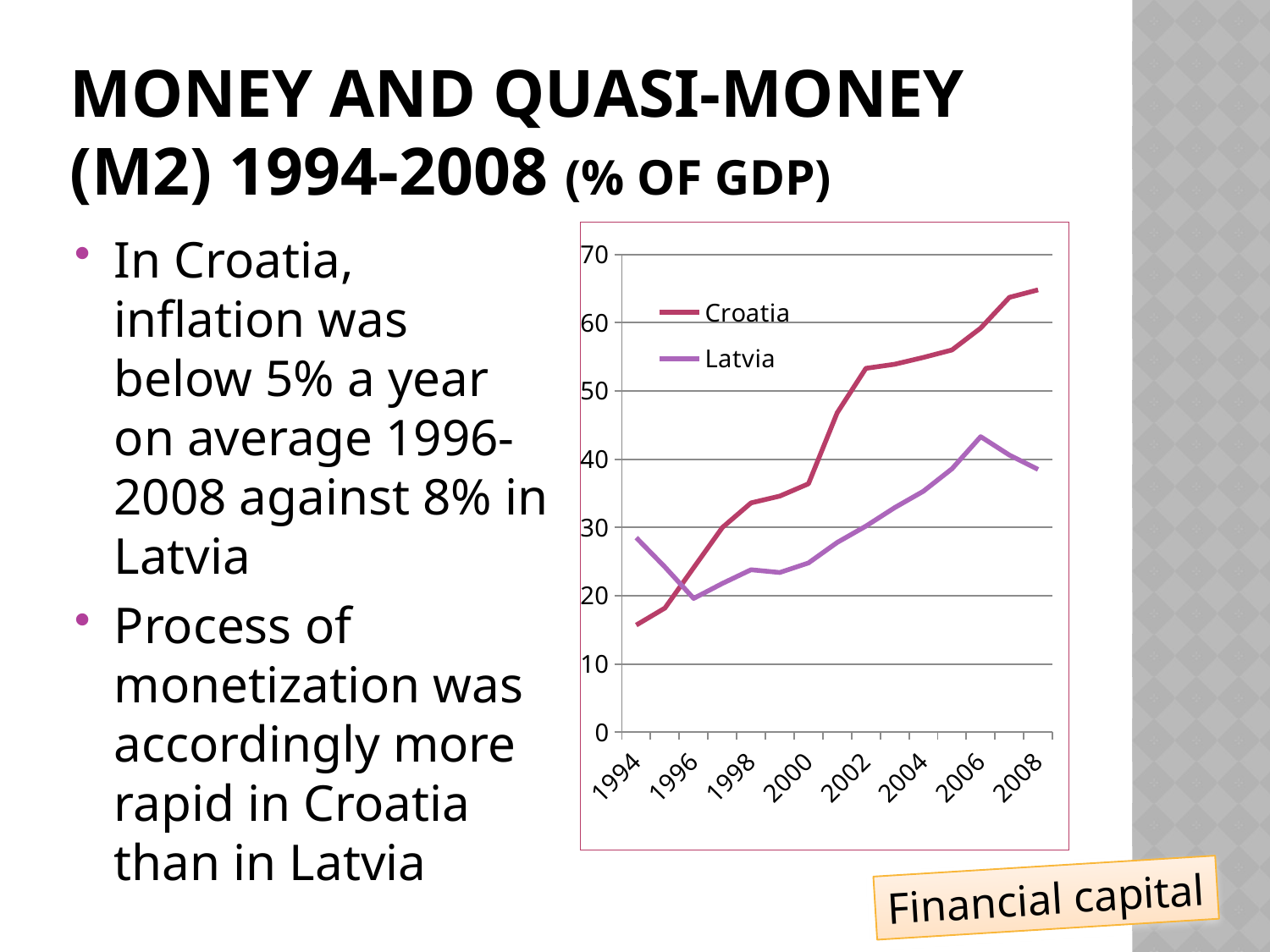
In 1994, which country has the higher value, Croatia or Latvia? Latvia What is the highest value shown on the chart's vertical axis? 70 In 2008, which country has the higher value, Croatia or Latvia? Croatia Is the value for Latvia in 2006 greater or less than 40? greater Is the value for Latvia in 2000 greater or less than 30? less Is the value for Croatia in 2008 greater or less than 60? greater In which year does the Latvia line reach its highest value? 2006 Does the Croatia line generally rise or fall from 1994 to 2008? rise Which two countries are shown in the chart legend? Croatia and Latvia What kind of chart is shown on the slide? line chart How many series does the chart legend list? 2